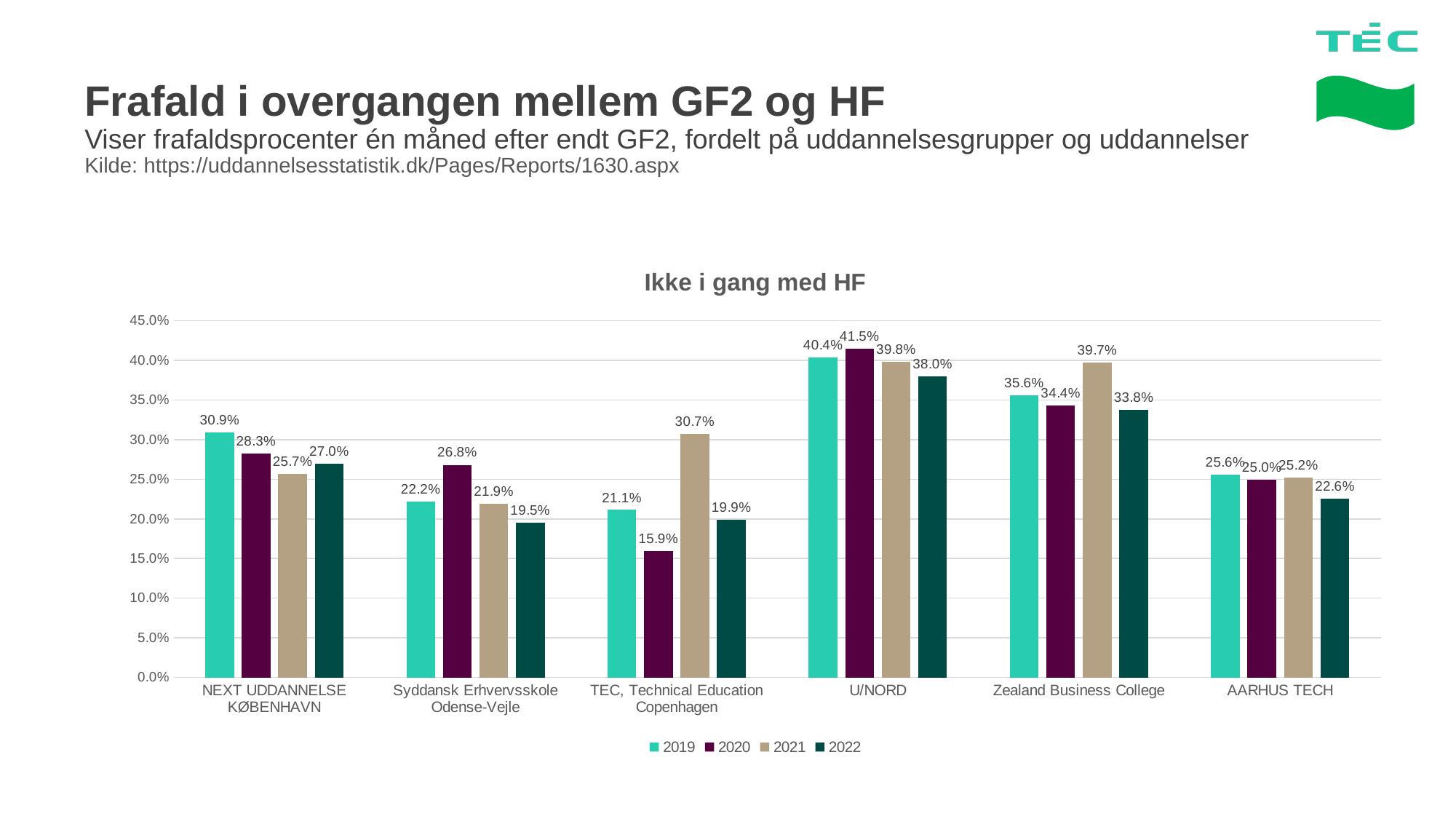
Which is larger for Zealand Business College: the 2021 value or the 2022 value? 2021 What is the title of the chart? Ikke i gang med HF How many institutions are shown on the x axis? 6 Which institution has the highest 2020 value? U/NORD What kind of chart is shown? bar chart What is the 2019 value for U/NORD? 40.4% What is the 2022 value for AARHUS TECH? 22.6% What is the difference between the 2019 and 2022 values for NEXT UDDANNELSE KØBENHAVN? 3.9% How many series does the legend list? 4 Is the 2020 value for Syddansk Erhvervsskole Odense-Vejle greater or less than 25.0%? greater Which institution has the lowest 2020 value? TEC, Technical Education Copenhagen What is the 2021 value for TEC, Technical Education Copenhagen? 30.7%